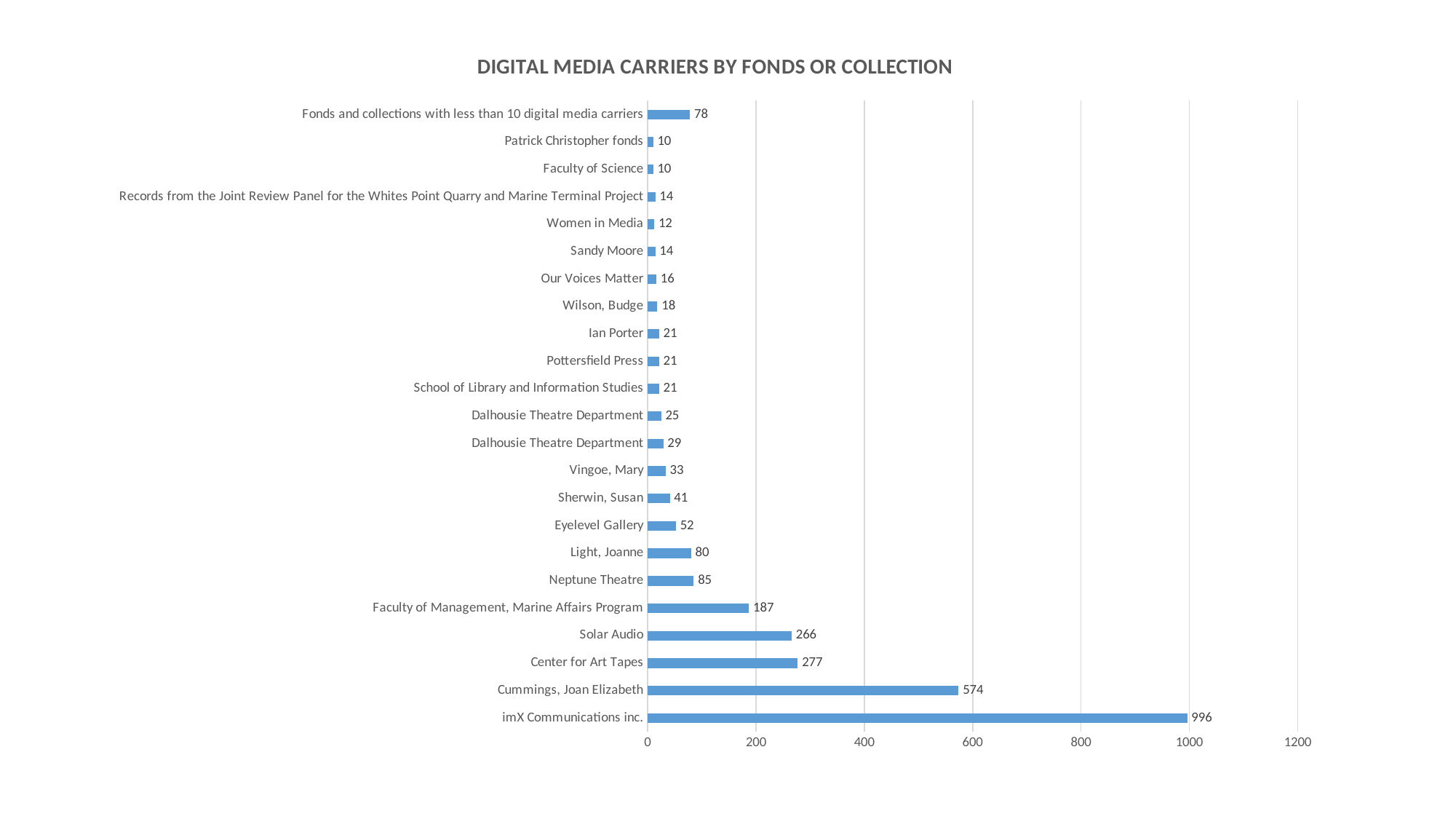
How many fonds or collections are plotted on the chart? 23 Is the value for Cummings, Joan Elizabeth greater or less than 600? less What is the difference between the values for imX Communications inc. and Cummings, Joan Elizabeth? 422 What kind of chart is shown on the slide? bar chart What is the title of the chart? DIGITAL MEDIA CARRIERS BY FONDS OR COLLECTION What is the value for imX Communications inc.? 996 What is the value for Neptune Theatre? 85 Which is larger, the value for Light, Joanne or the value for Eyelevel Gallery? Light, Joanne What is the difference between the values for Center for Art Tapes and Solar Audio? 11 How many digital media carriers does Cummings, Joan Elizabeth have? 574 Which fonds or collection has the highest number of digital media carriers? imX Communications inc. What is the value for Faculty of Management, Marine Affairs Program? 187